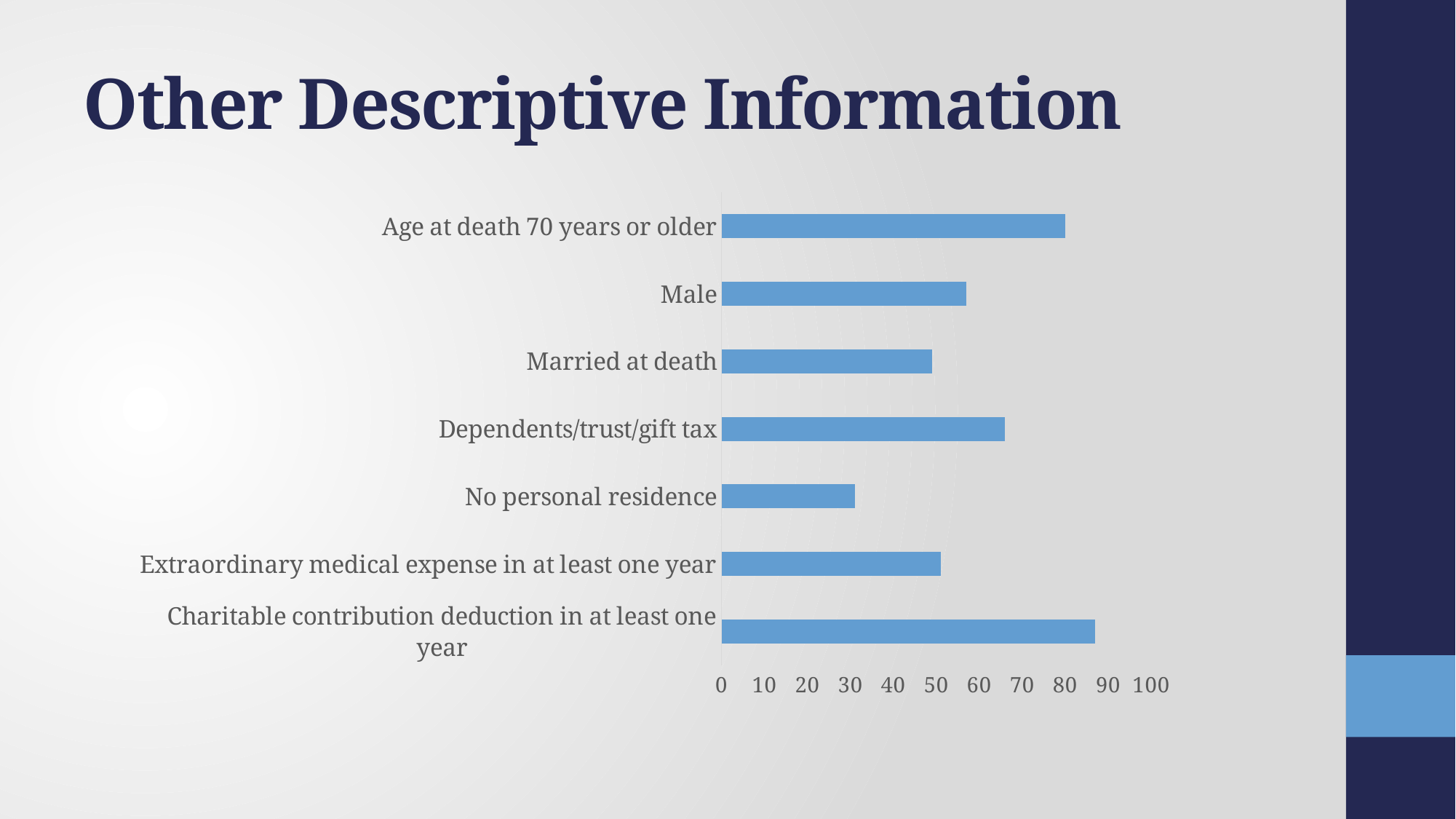
Is the value for Male greater or less than 50? greater Is the value for Dependents/trust/gift tax greater or less than 60? greater What is the title of the slide containing the chart? Other Descriptive Information Which is larger, the value for Dependents/trust/gift tax or the value for Extraordinary medical expense in at least one year? Dependents/trust/gift tax Is the value for Married at death greater or less than 40? greater How many categories are plotted in the chart? 7 Which category has the lowest value? No personal residence Which is larger, the value for Male or the value for Married at death? Male Which category has the highest value? Charitable contribution deduction in at least one year What kind of chart is shown on the slide? bar chart